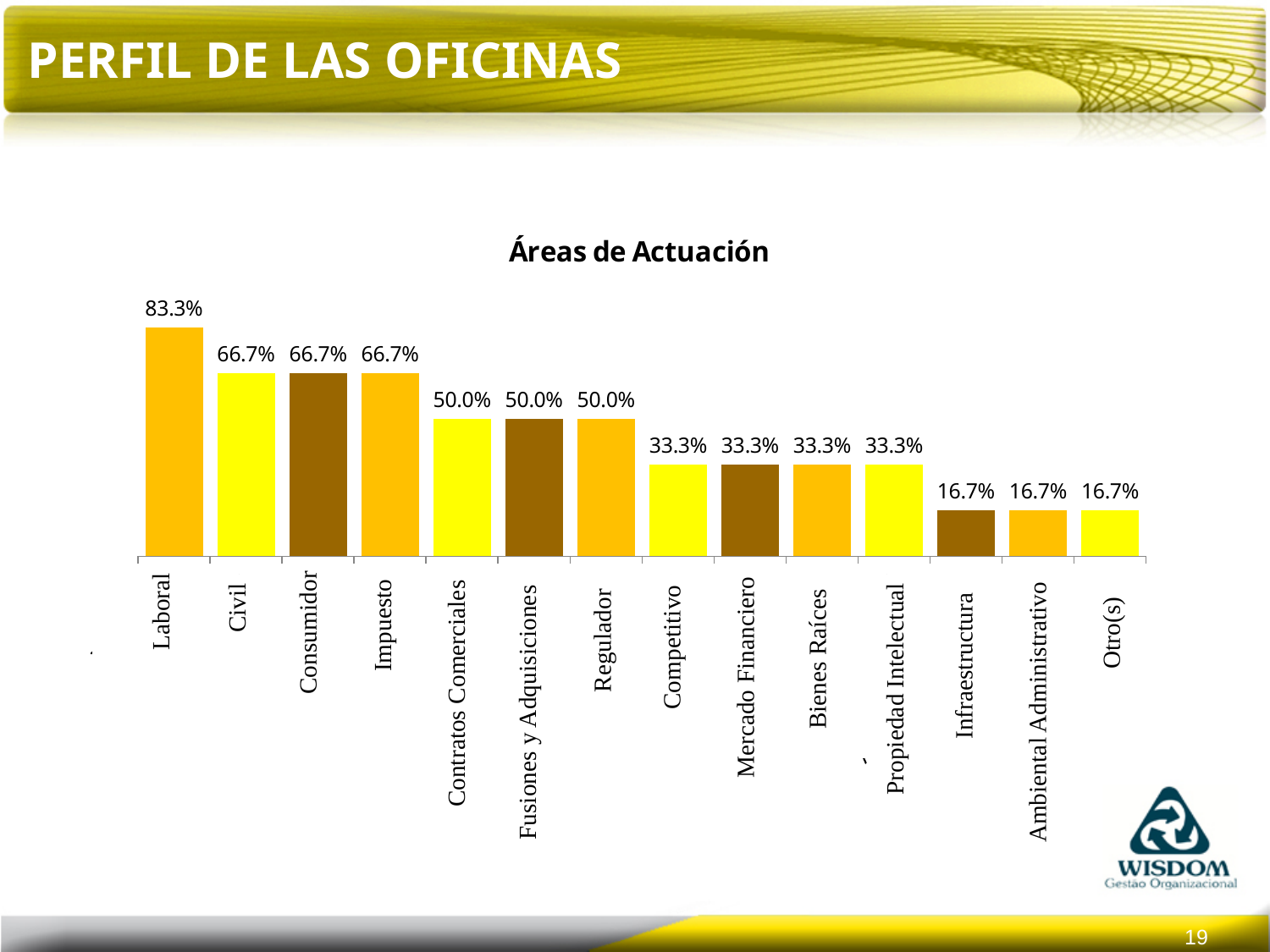
Which category has the highest value? Laboral Do the values rise or fall from left to right along the x axis? fall What kind of chart is this? bar chart What is the title of the chart? Áreas de Actuación What is the value for Ambiental Administrativo? 16.7% What is the difference between the values for Laboral and Civil? 16.6% What is the value for Regulador? 50.0% Which is larger, the value for Consumidor or the value for Competitivo? Consumidor What is the difference between the values for Impuesto and Infraestructura? 50.0% How many categories are shown in the chart? 14 What is the value for Laboral? 83.3% What is the value for Propiedad Intelectual? 33.3%